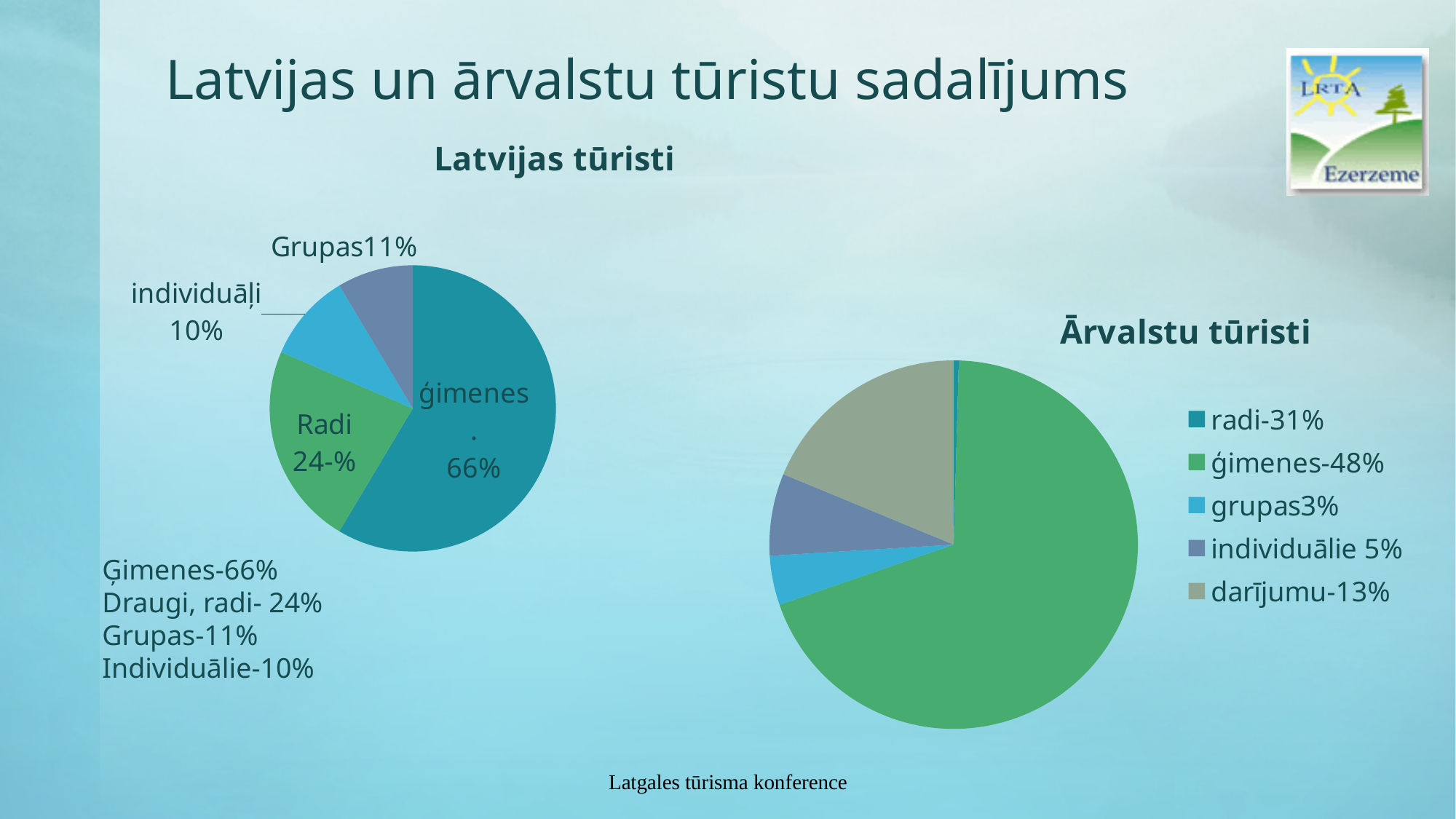
In the "Latvijas tūristi" chart, what share is labelled for Radi? 24% How many slices does the "Latvijas tūristi" pie chart have? 4 In the "Ārvalstu tūristi" chart, which category has the largest slice? ģimenes In the "Ārvalstu tūristi" chart, what percentage does the legend give for ģimenes? 48% In the "Latvijas tūristi" chart, which category has the largest slice? ģimenes In the "Latvijas tūristi" chart, what share is labelled for Grupas? 11% How many categories does the legend of the "Ārvalstu tūristi" chart list? 5 In the "Latvijas tūristi" chart, what share is labelled for ģimenes? 66% In the "Latvijas tūristi" chart, what share is labelled for individuāļi? 10% In the "Latvijas tūristi" chart, how many percentage points larger is ģimenes than Radi? 42% What kind of chart is the "Latvijas tūristi" chart? pie chart In the "Ārvalstu tūristi" chart, what percentage does the legend give for darījumu? 13%